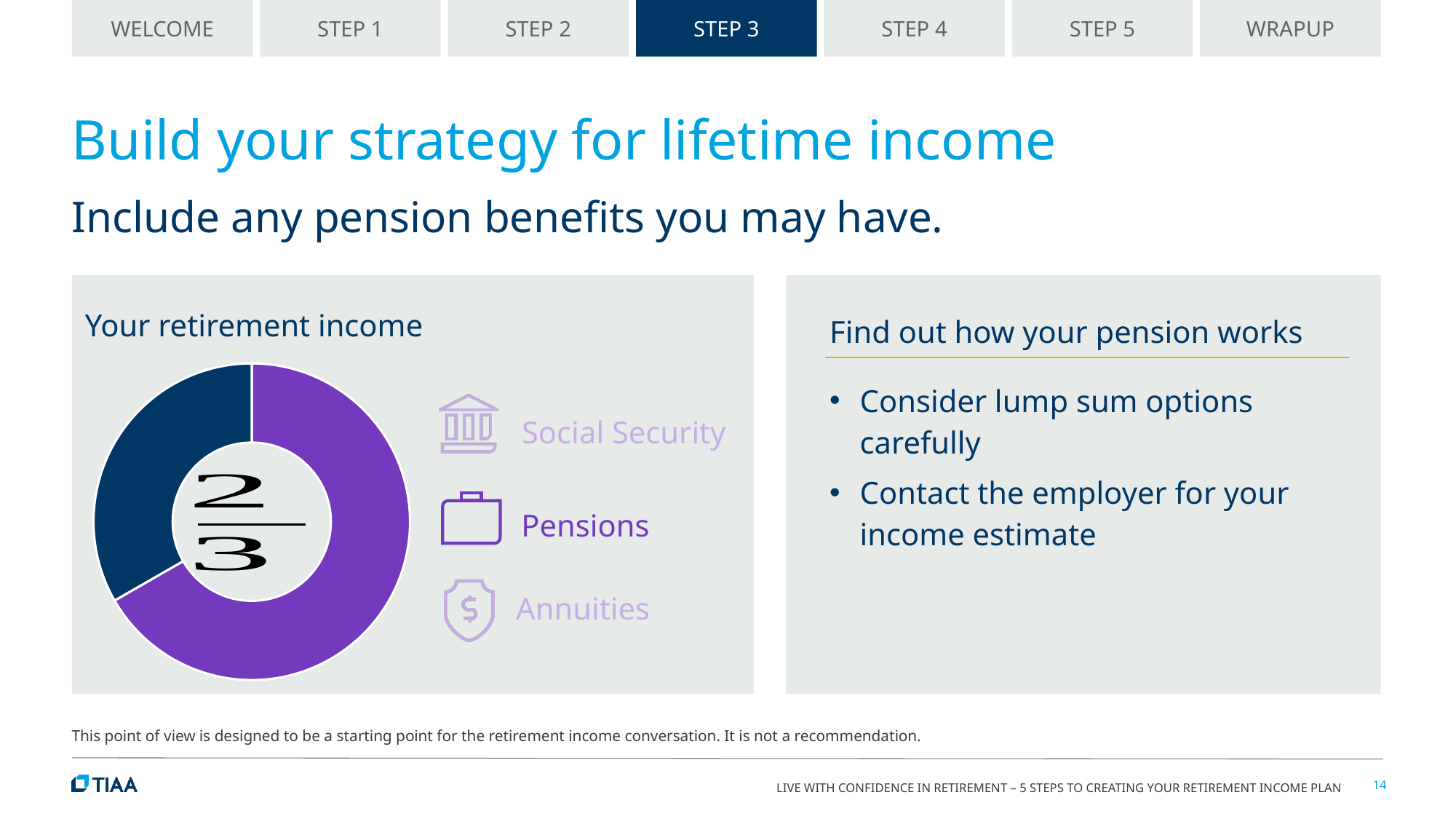
Is the dark navy slice of the donut chart greater or less than half of the chart? less Which legend entry appears first in the list next to the donut chart? Social Security Which legend entry is highlighted in purple next to the donut chart? Pensions Is the purple slice of the donut chart greater or less than half of the chart? greater How many entries are listed in the legend next to the donut chart? 3 What kind of chart is shown under "Your retirement income"? Donut (pie) chart How many slices does the donut chart have? 2 What fraction is printed in the centre of the donut chart? 2/3 What is the title of the chart on the left of the slide? Your retirement income Which slice of the donut chart is larger, the purple one or the dark navy one? The purple one